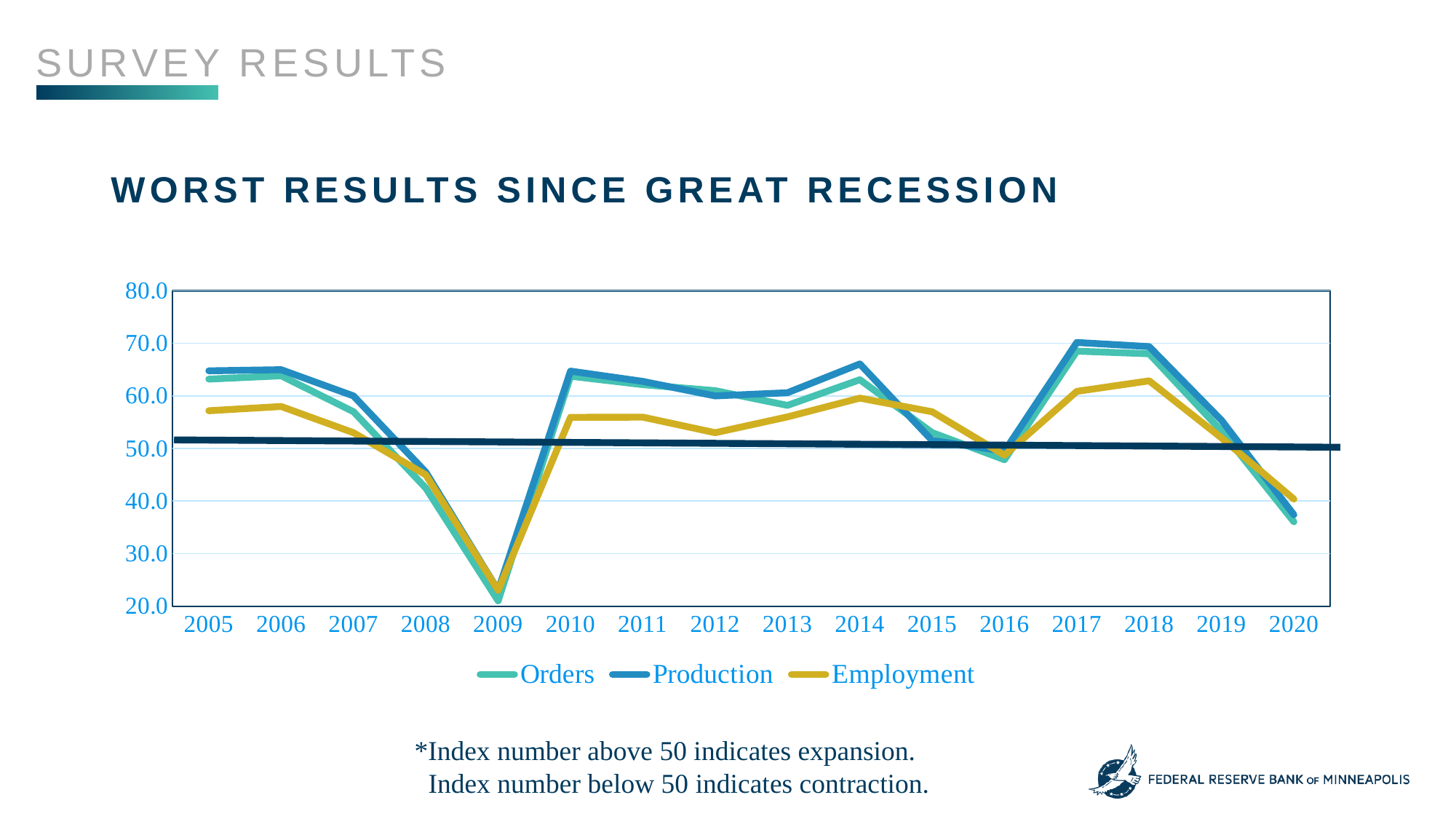
In which year is the Orders series at its lowest? 2009 Is the value for Orders in 2009 greater or less than 30? less Which is higher in 2017, Production or Employment? Production Is the value for Production in 2014 greater or less than 60? greater How many series does the legend list? 3 Is the value for Orders in 2020 greater or less than 40? less How many years are shown on the x axis? 16 What is the title of the chart? WORST RESULTS SINCE GREAT RECESSION In which year is the Production series at its lowest? 2009 Do the values for Production rise or fall from 2018 to 2020? fall What kind of chart is shown on the slide? line chart